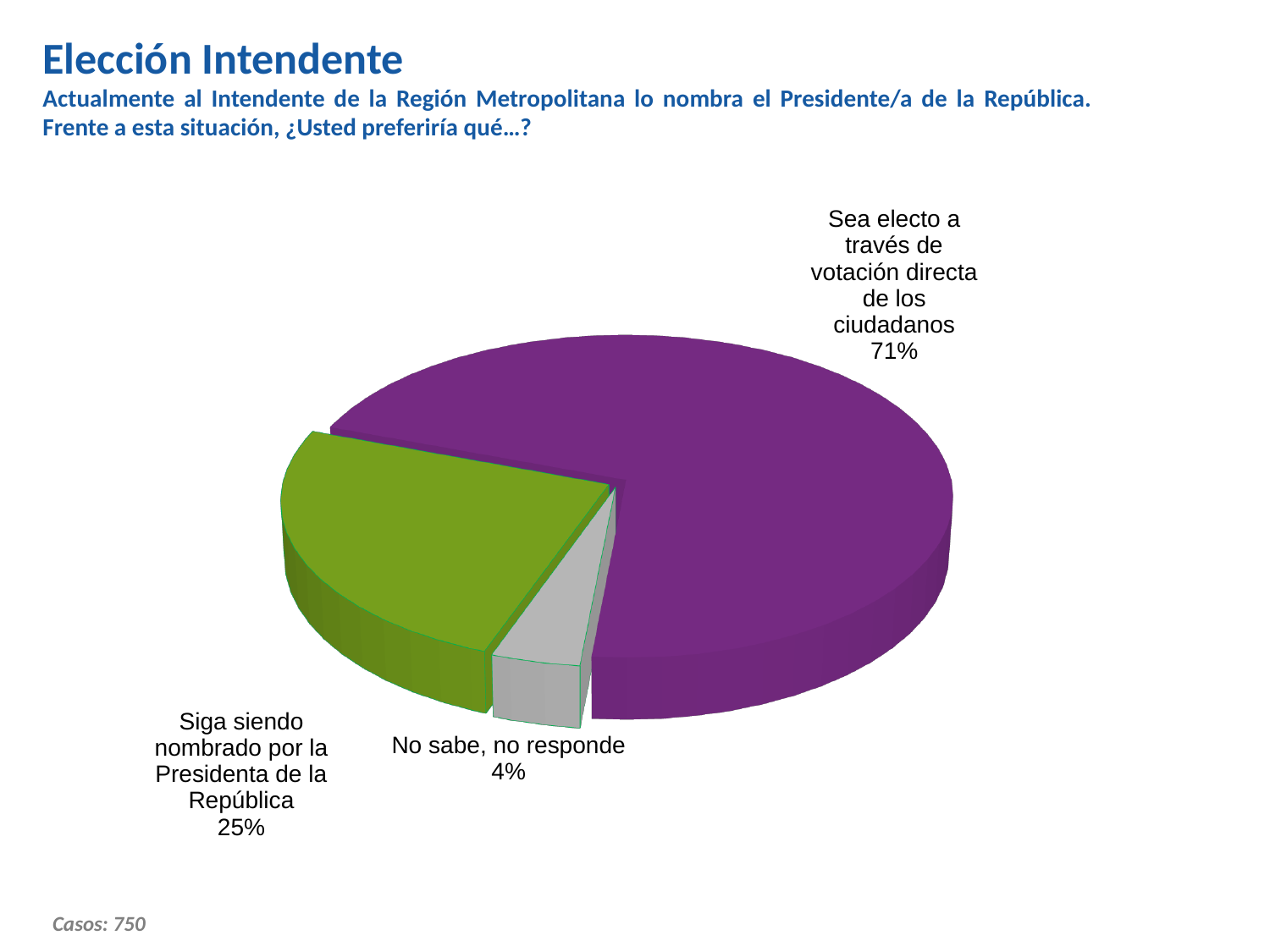
What kind of chart is shown on the slide? Pie chart What is the difference in percentage points between "Sea electo a través de votación directa de los ciudadanos" and "Siga siendo nombrado por la Presidenta de la República"? 46 percentage points How many slices does the pie chart have? 3 What percentage of respondents prefer that the Intendente be elected through direct vote of the citizens ("Sea electo a través de votación directa de los ciudadanos")? 71% What colour is the slice for "Sea electo a través de votación directa de los ciudadanos"? Purple How many cases ("Casos") does the slide report for the survey? 750 What percentage of respondents prefer that the Intendente continue to be appointed by the President ("Siga siendo nombrado por la Presidenta de la República")? 25% Which option has the largest share of the pie? Sea electo a través de votación directa de los ciudadanos Which is larger: the share for "Siga siendo nombrado por la Presidenta de la República" or the share for "No sabe, no responde"? Siga siendo nombrado por la Presidenta de la República What percentage corresponds to "No sabe, no responde"? 4% What is the combined percentage of "Siga siendo nombrado por la Presidenta de la República" and "No sabe, no responde"? 29% Which option has the smallest share of the pie? No sabe, no responde